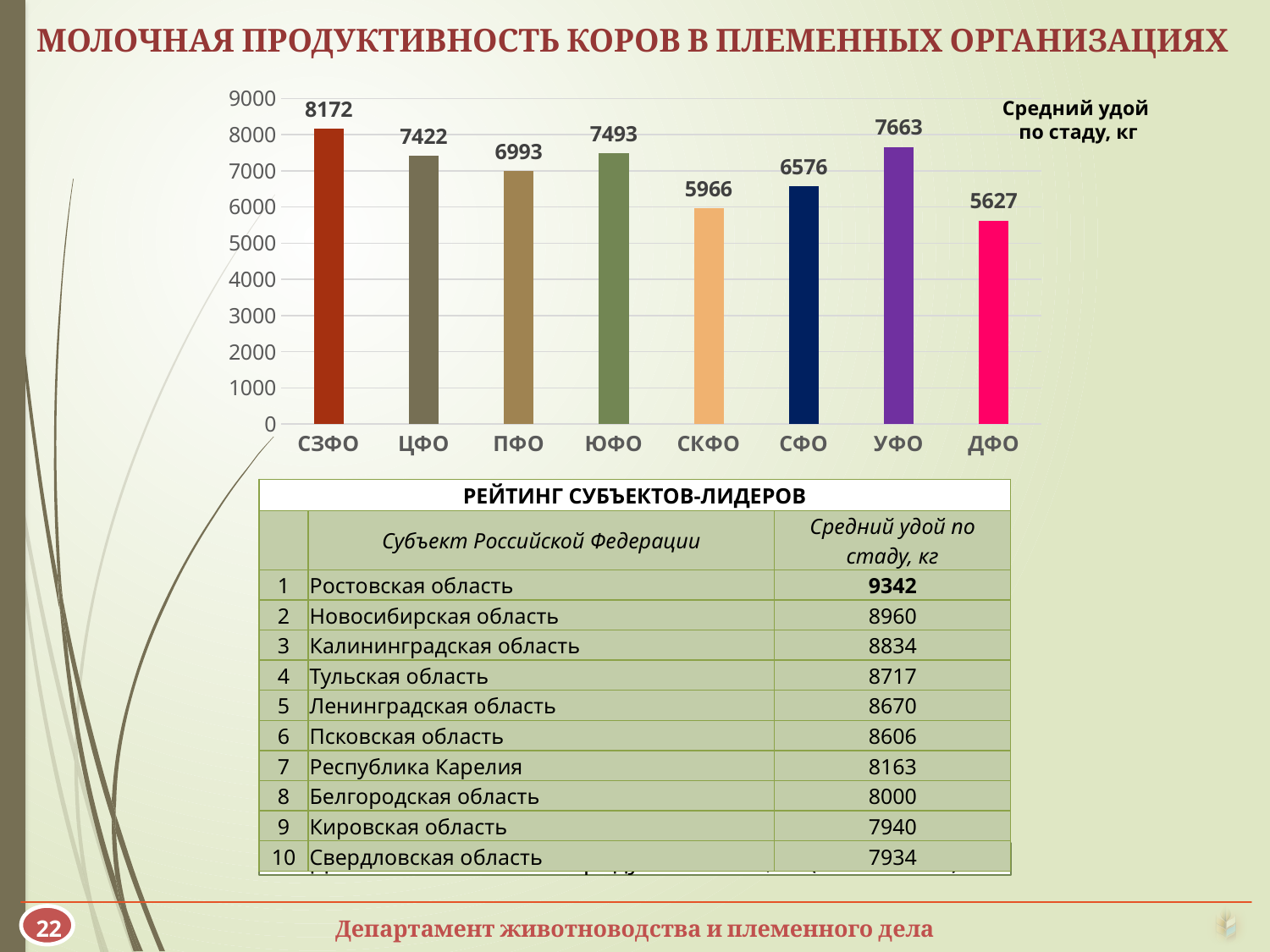
What is the difference between the values for СЗФО and ДФО? 2545 What is the average milk yield per herd for СЗФО? 8172 What is the value shown for СКФО? 5966 Is the value for СКФО greater or less than 6000? less What is the value shown for УФО? 7663 What type of chart is used on the slide? bar chart Which federal district has the highest average milk yield per herd? СЗФО Which has a higher value, ПФО or СФО? ПФО What is the label of the series shown in the chart? Средний удой по стаду, кг How many federal districts are shown in the bar chart? 8 Which federal district has the lowest average milk yield per herd? ДФО What is the difference between the values for ЮФО and ЦФО? 71